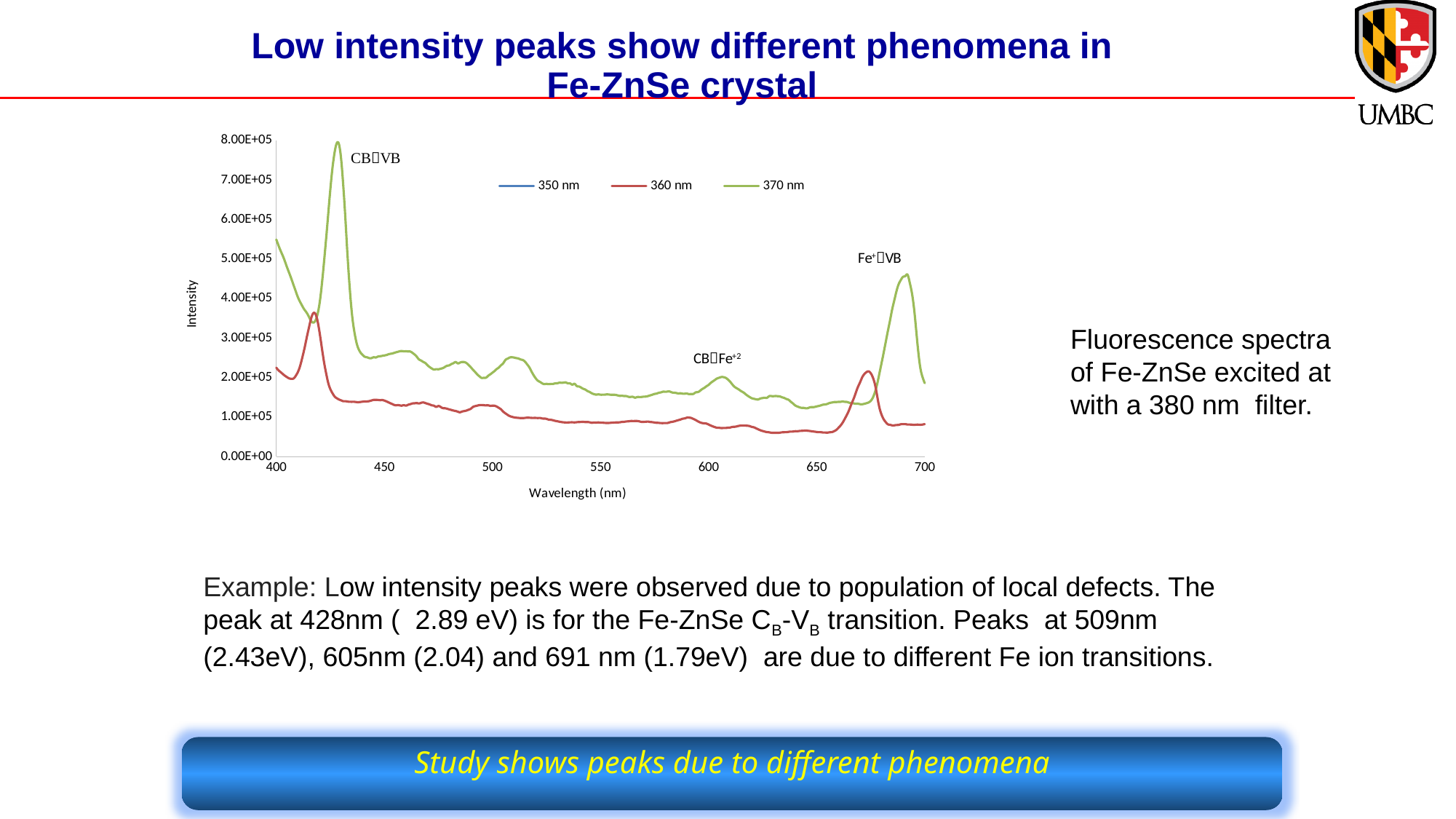
Does the 360 nm series generally rise or fall between 450 nm and 650 nm? fall Which series reaches the highest intensity anywhere on the chart? 370 nm At 600 nm, which series has the higher intensity, 360 nm or 370 nm? 370 nm Is the peak of the 370 nm series near 691 nm greater or less than 4.00E+05? greater Which colour is used for the 360 nm series in the chart? red Is the peak of the 360 nm series near 420 nm greater or less than 4.00E+05? less How many series does the chart legend list? 3 Is the highest peak of the 370 nm series (near 428 nm) greater or less than 7.00E+05? greater What kind of chart is shown on the slide? line chart What is the title of the x axis of the chart? Wavelength (nm)